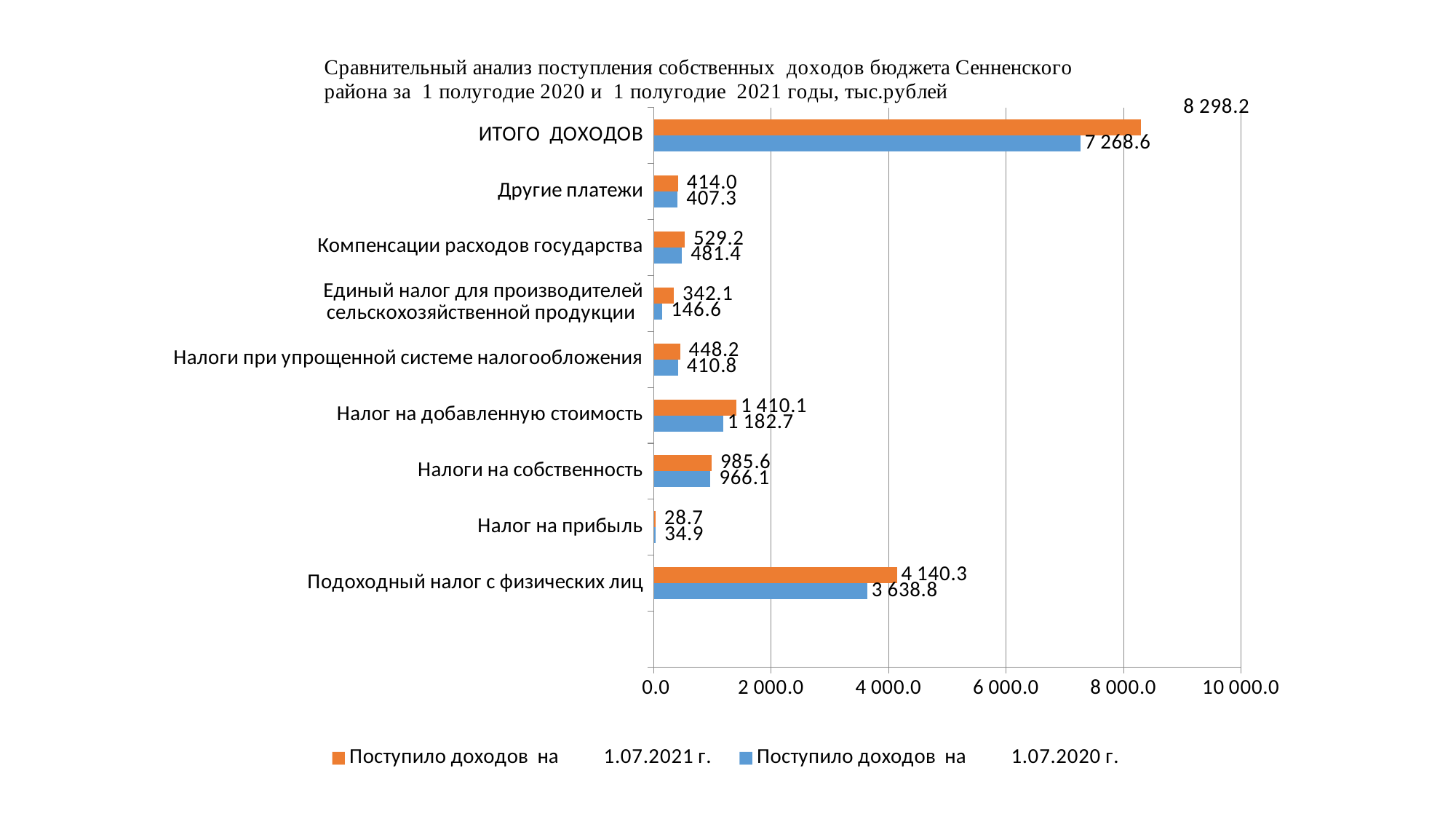
What is the value for "Налог на добавленную стоимость" in the series "Поступило доходов на 1.07.2020 г."? 1 182.7 What is the difference between the 1.07.2021 and 1.07.2020 values for "Единый налог для производителей сельскохозяйственной продукции"? 195.5 For "Налог на прибыль", which series has the larger value: 1.07.2021 or 1.07.2020? 1.07.2020 What is the value for "ИТОГО ДОХОДОВ" in the series "Поступило доходов на 1.07.2020 г."? 7 268.6 Which colour represents the series "Поступило доходов на 1.07.2021 г."? Orange What type of chart is shown on the slide? Bar chart How many series does the legend list? 2 What is the value for "Подоходный налог с физических лиц" in the series "Поступило доходов на 1.07.2021 г."? 4 140.3 Is the value for "Подоходный налог с физических лиц" in the series "Поступило доходов на 1.07.2020 г." greater or less than 4 000.0? less Excluding "ИТОГО ДОХОДОВ", which category has the highest value in the series "Поступило доходов на 1.07.2020 г."? Подоходный налог с физических лиц Excluding "ИТОГО ДОХОДОВ", which category has the lowest value in the series "Поступило доходов на 1.07.2021 г."? Налог на прибыль How many categories are shown on the vertical axis of the chart? 9